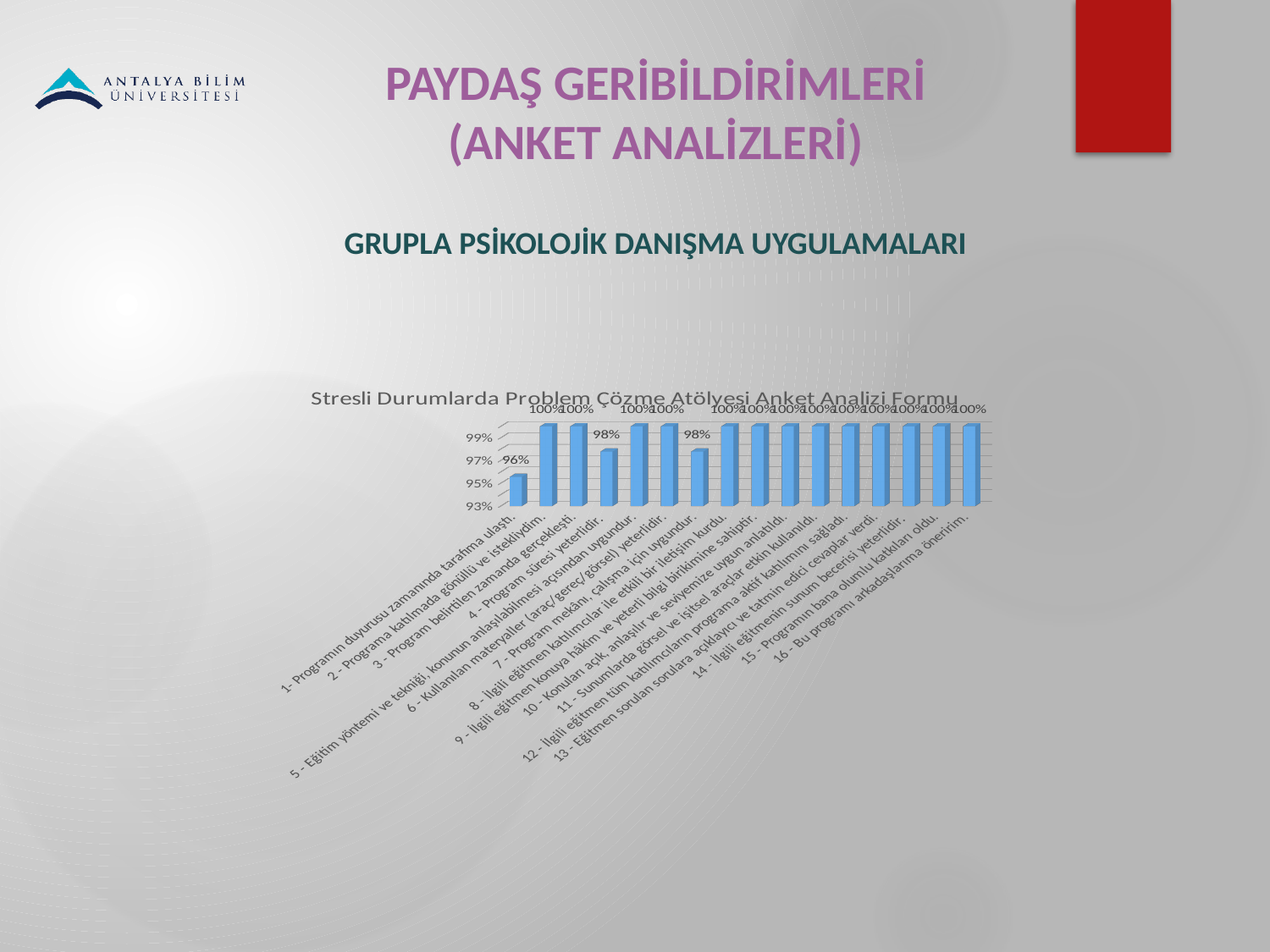
What is the value for "1- Programın duyurusu zamanında tarafıma ulaştı."? 96% Which category has the lowest value in the chart? 1- Programın duyurusu zamanında tarafıma ulaştı. What is the title of the chart? Stresli Durumlarda Problem Çözme Atölyesi Anket Analizi Formu How many categories (survey items) are plotted in the chart? 16 Is the value for "1- Programın duyurusu zamanında tarafıma ulaştı." greater or less than 97%? less What is the value for "4 - Program süresi yeterlidir."? 98% What is the value for "16 - Bu programı arkadaşlarıma öneririm."? 100% What is the value for "7 - Program mekanı, çalışma için uygundur."? 98% What is the difference between the value for "2 - Programa katılmada gönüllü ve istekliydim." and the value for "1- Programın duyurusu zamanında tarafıma ulaştı."? 4% How many categories in the chart have a value of 100%? 13 What type of chart is shown on the slide? bar chart Which is larger: the value for "4 - Program süresi yeterlidir." or the value for "5 - Eğitim yöntemi ve tekniği, konunun anlaşılabilmesi açısından uygundur."? 5 - Eğitim yöntemi ve tekniği, konunun anlaşılabilmesi açısından uygundur.